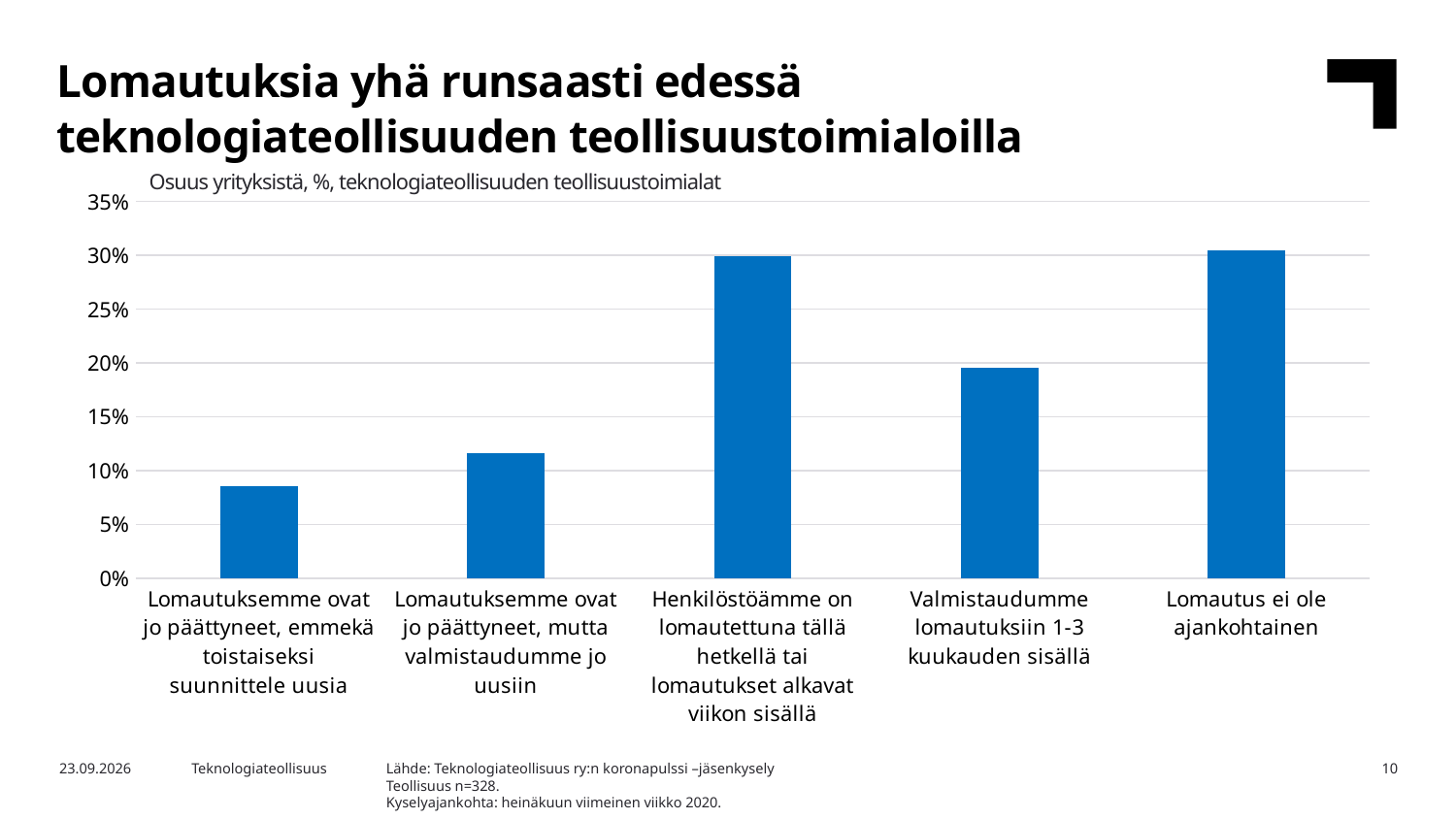
Is the value for "Lomautuksemme ovat jo päättyneet, emmekä toistaiseksi suunnittele uusia" greater or less than 10%? less Which is larger: the value for "Henkilöstöämme on lomautettuna tällä hetkellä tai lomautukset alkavat viikon sisällä" or the value for "Lomautuksemme ovat jo päättyneet, emmekä toistaiseksi suunnittele uusia"? Henkilöstöämme on lomautettuna tällä hetkellä tai lomautukset alkavat viikon sisällä Is the value for "Lomautus ei ole ajankohtainen" greater or less than 25%? greater What is the subtitle text shown above the chart? Osuus yrityksistä, %, teknologiateollisuuden teollisuustoimialat Is the value for "Lomautuksemme ovat jo päättyneet, mutta valmistaudumme jo uusiin" greater or less than 10%? greater Which is larger: the value for "Valmistaudumme lomautuksiin 1-3 kuukauden sisällä" or the value for "Lomautuksemme ovat jo päättyneet, mutta valmistaudumme jo uusiin"? Valmistaudumme lomautuksiin 1-3 kuukauden sisällä What is the highest value shown on the y axis of the chart? 35% What kind of chart is shown on the slide? bar chart How many categories are shown on the x axis of the chart? 5 Which category has the lowest value in the chart? Lomautuksemme ovat jo päättyneet, emmekä toistaiseksi suunnittele uusia